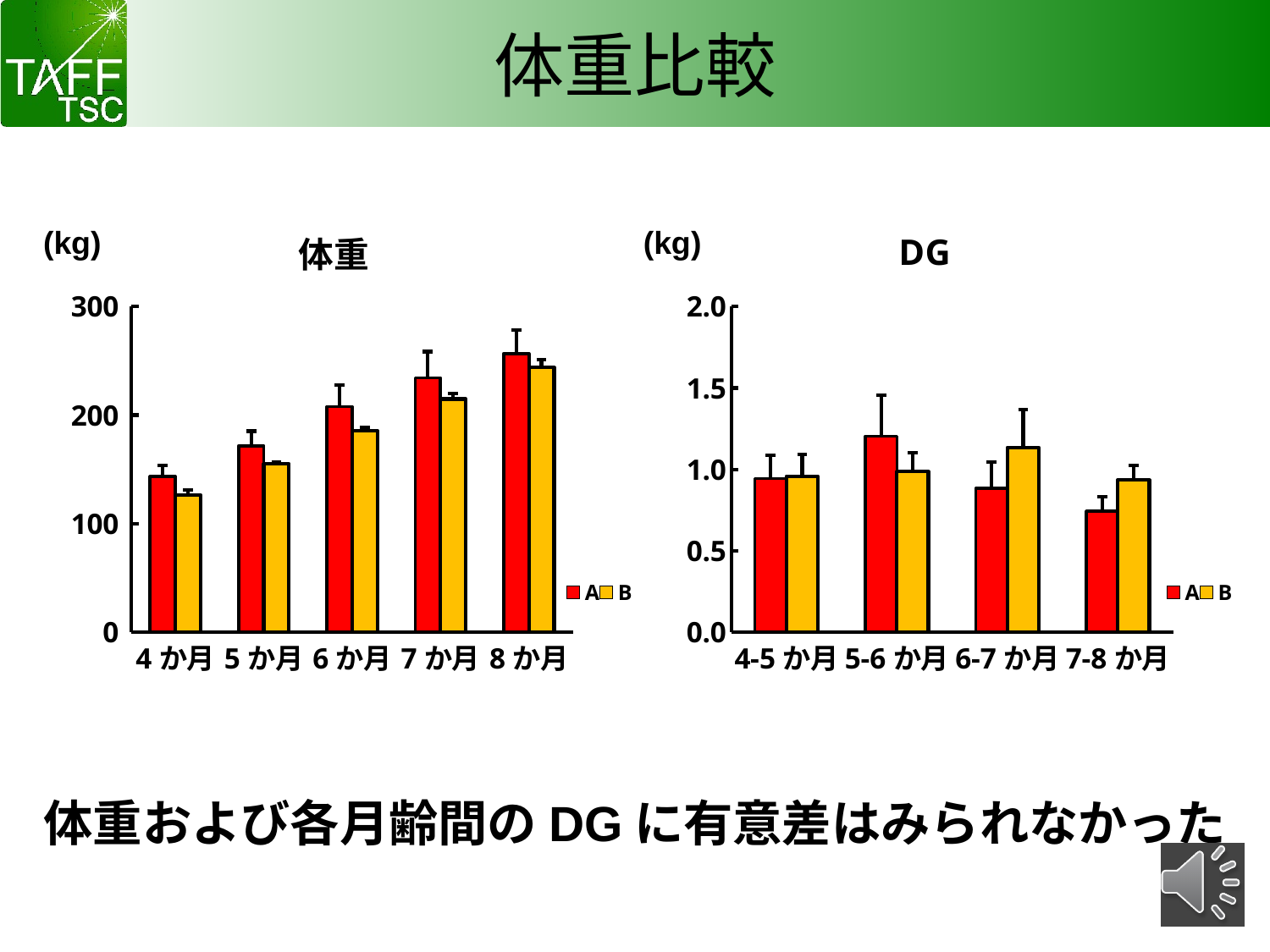
In the 体重 chart on the left, is the value for series B at 4 か月 greater or less than 200? less In the DG chart on the right, which series has the larger value at 6-7 か月, A or B? B In the DG chart on the right, is the value for series A at 7-8 か月 greater or less than 1.0? less In the 体重 chart on the left, do the values for series A rise or fall from 4 か月 to 8 か月? rise In the 体重 chart on the left, at which age is the value for series B lowest? 4 か月 What kind of chart is the 体重 chart on the left? bar chart In the 体重 chart on the left, how many series does the legend list? 2 In the 体重 chart on the left, is the value for series A at 4 か月 greater or less than 100? greater In the 体重 chart on the left, which series has the larger value at 6 か月, A or B? A In the DG chart on the right, how many age-interval categories are shown on the x axis? 4 In the DG chart on the right, at which interval is the value for series A highest? 5-6 か月 In the 体重 chart on the left, how many age categories are shown on the x axis? 5